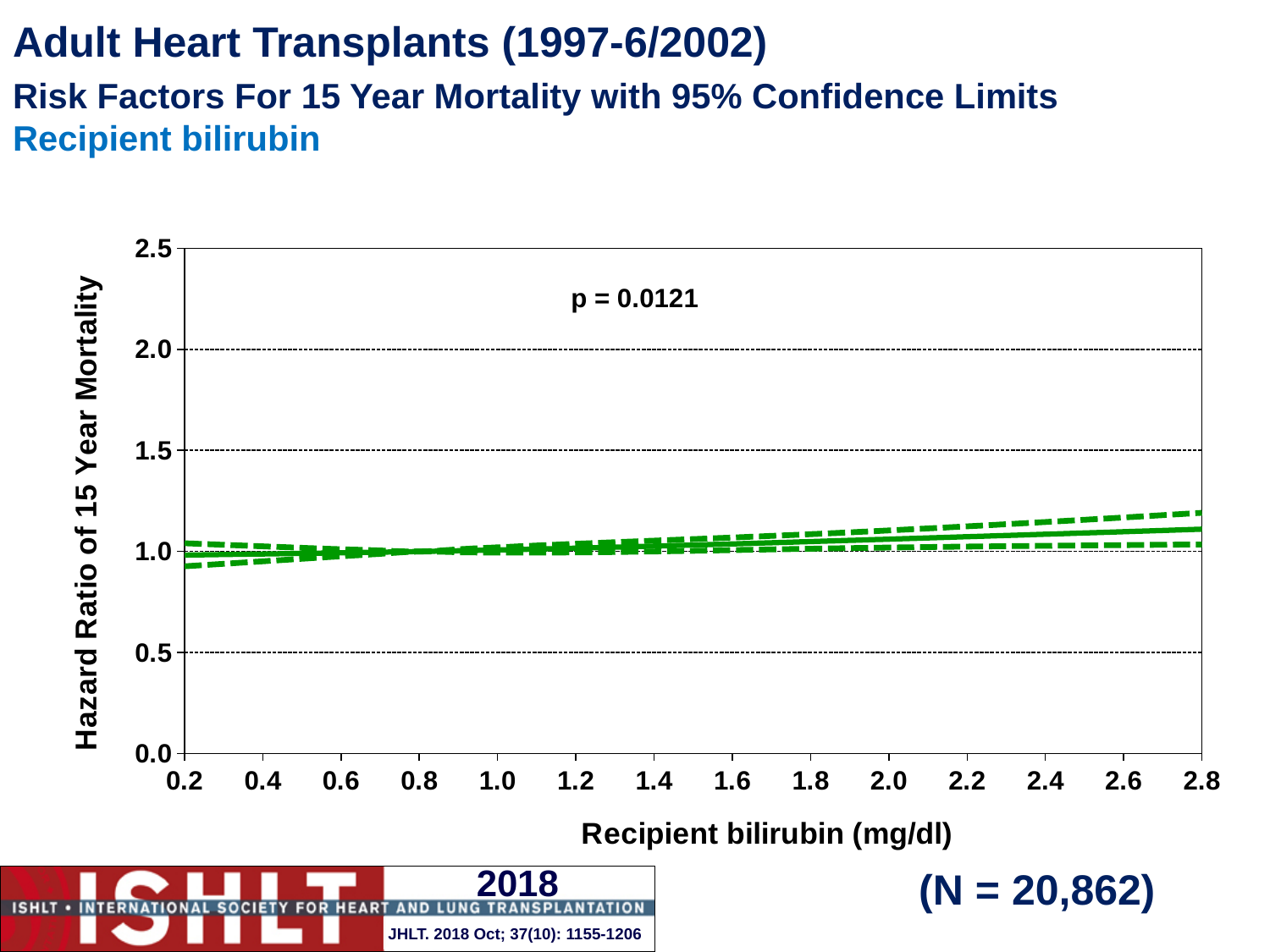
What is the label of the x axis? Recipient bilirubin (mg/dl) What is the lowest recipient bilirubin value labelled on the x axis? 0.2 Does the hazard ratio of 15 year mortality rise or fall as recipient bilirubin increases along the x axis? Rise Is the hazard ratio at a recipient bilirubin of 2.8 mg/dl greater or less than 1.0? greater How many tick labels are shown on the x axis? 14 Is the hazard ratio at a recipient bilirubin of 1.0 mg/dl greater or less than 2.0? less What p-value is printed on the chart? p = 0.0121 Is the upper 95% confidence limit at a recipient bilirubin of 2.8 mg/dl greater or less than 1.5? less What kind of chart is shown on the slide? Line chart What is the highest value labelled on the y axis? 2.5 What is the sample size (N) shown on the slide? N = 20,862